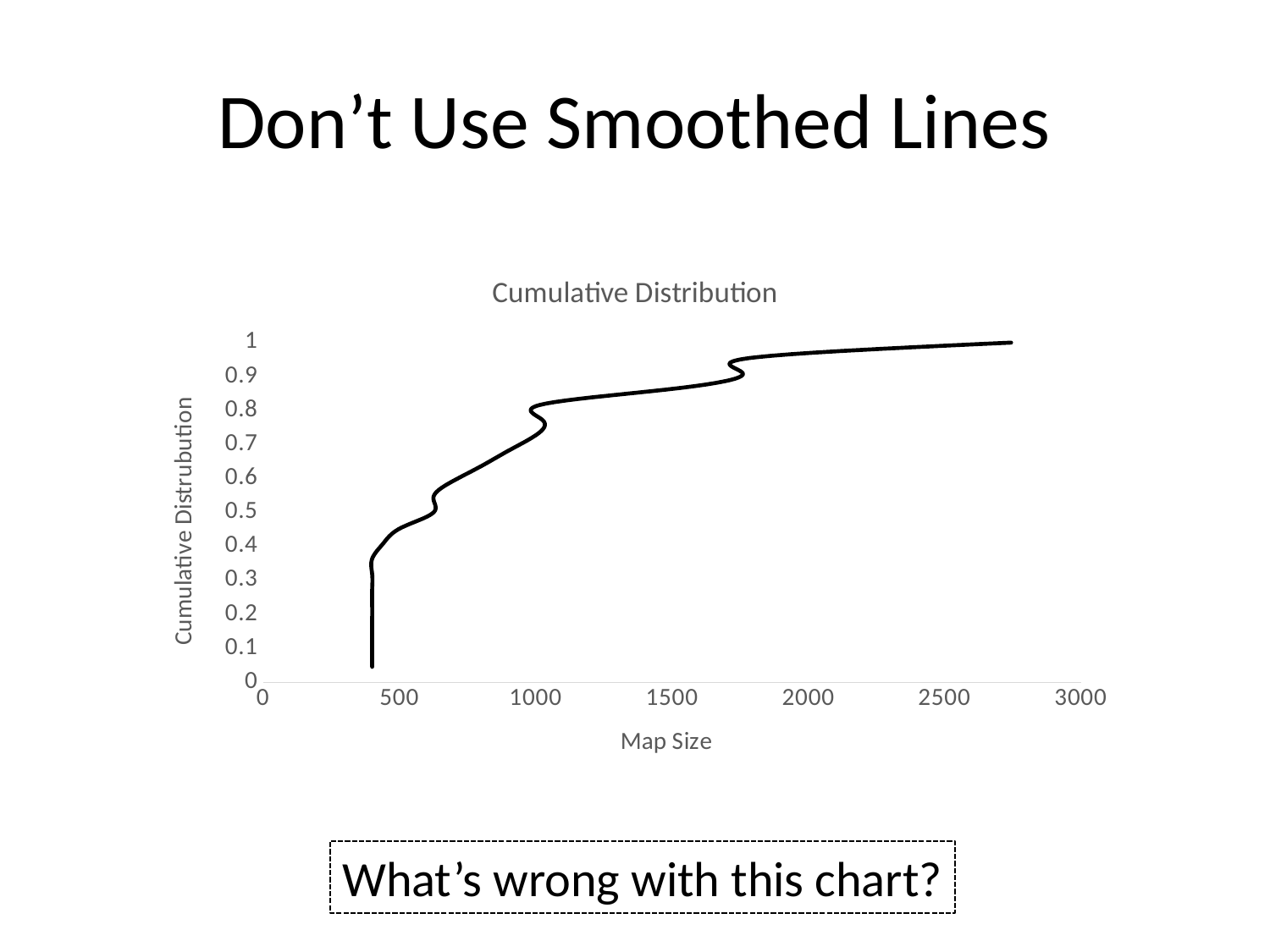
What kind of chart is shown on the slide? line chart Is the cumulative distribution value at a map size of 500 greater or less than 0.7? less What is the largest tick value shown on the x axis? 3000 Is the cumulative distribution value at a map size of 1000 greater or less than 0.5? greater Does the plotted line rise or fall as Map Size increases? rises What is the highest tick value shown on the y axis? 1 Is the cumulative distribution value at a map size of 1500 greater or less than 0.7? greater What is the title of the chart? Cumulative Distribution What is the label on the x axis of the chart? Map Size